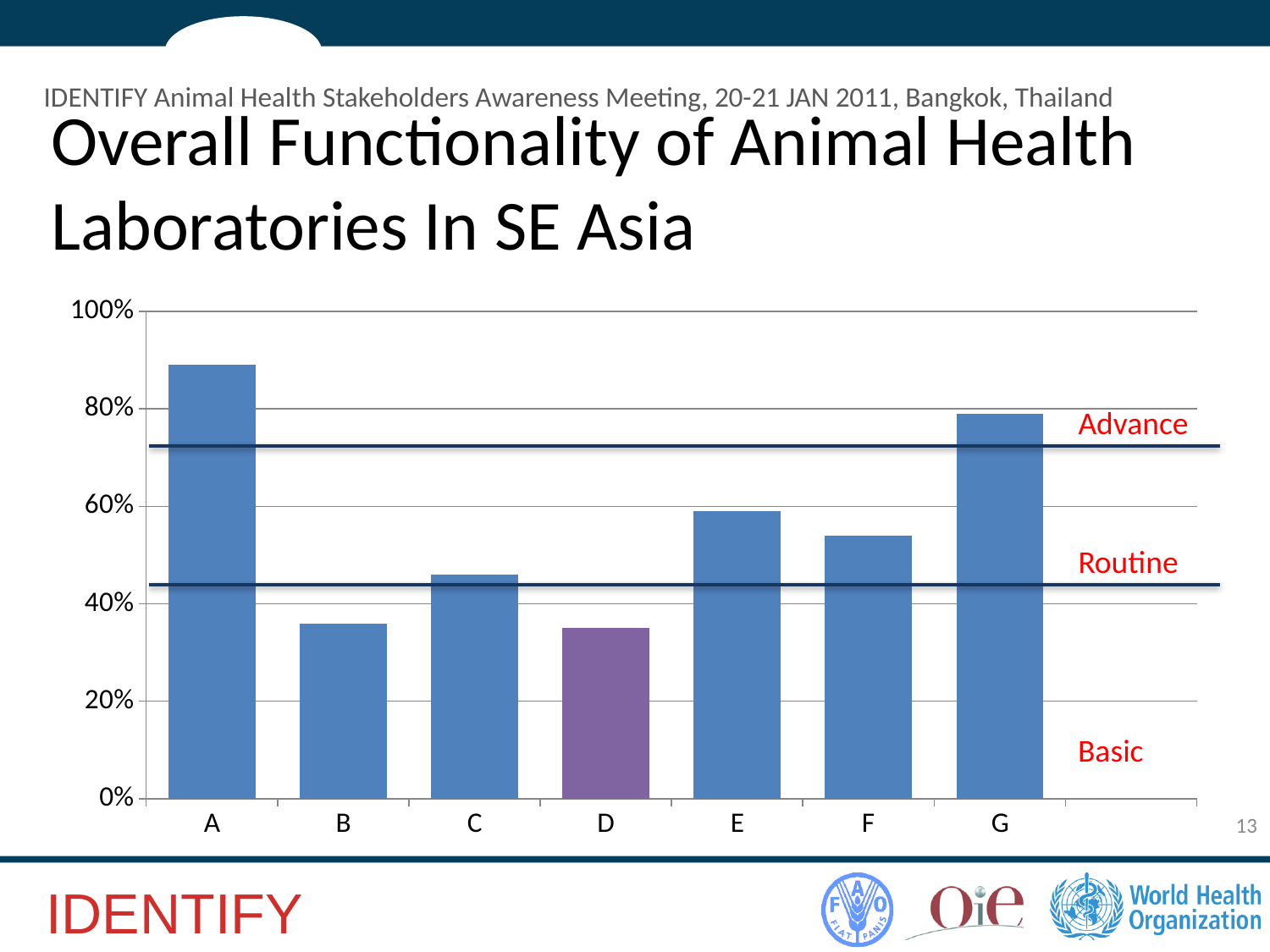
Which is larger, the value for A or the value for G? A Is the value for G greater or less than 60%? greater Is the value for A greater or less than 80%? greater Is the value for C greater or less than 40%? greater What kind of chart is shown on the slide? bar chart Which is larger, the value for E or the value for F? E Which category's bar is shown in a different colour (purple) from the others? D Which category has the highest value? A How many categories are plotted on the x axis? 7